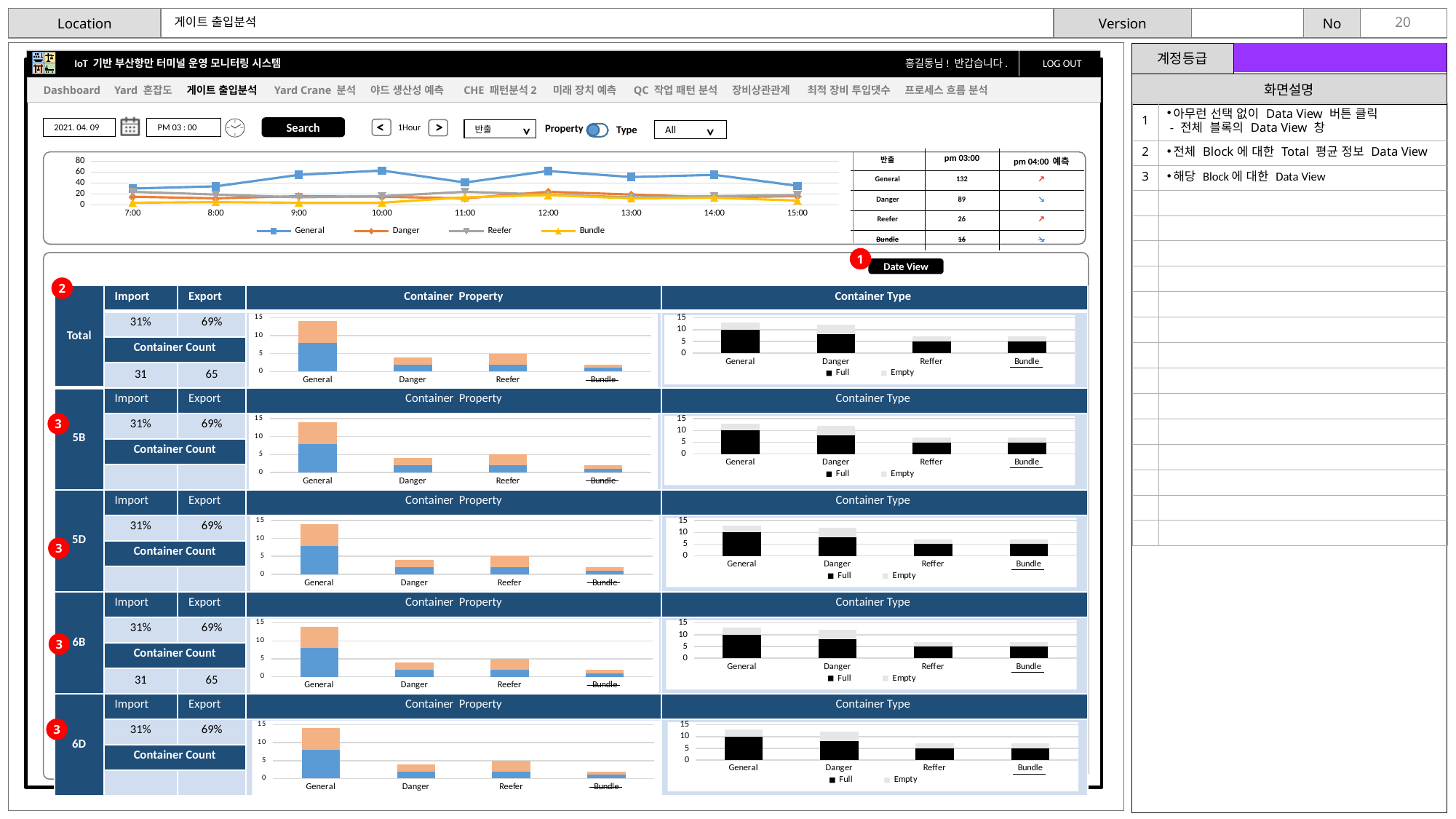
In the Total row's Container Property chart, what kind of chart is shown? bar chart In the Total row's Container Property chart, is the total bar for General greater or less than 10? greater In the Total row's Container Property chart, how many categories are shown on the x axis? 4 In the top line chart, is the value for General at 10:00 greater or less than 40? greater In the top line chart, which is larger at 12:00: General or Danger? General In the top line chart, is the value for Bundle at 7:00 greater or less than 20? less How many series does the legend of the top line chart list? 4 What kind of chart is the chart at the top of the slide showing values from 7:00 to 15:00? line chart How many time points are plotted along the x axis of the top line chart? 9 In the top line chart, which series has the highest values across the time points? General In the Total row's Container Property chart, which category has the tallest bar? General In the Total row's Container Type chart, what are the two legend entries? Full, Empty